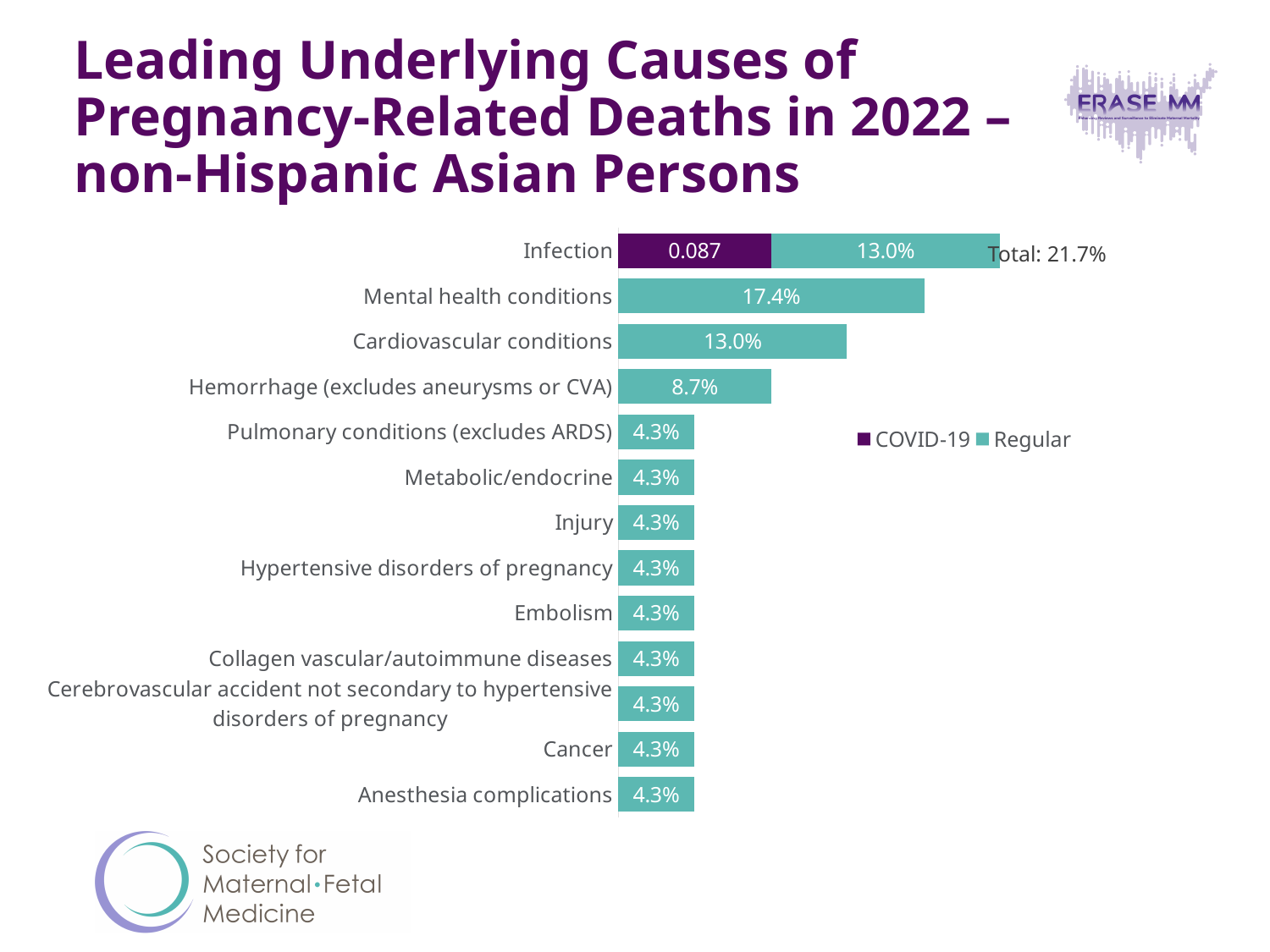
What is the Regular value for Mental health conditions? 17.4% What is the total shown for the Infection bar? 21.7% What is the Regular value for Cardiovascular conditions? 13.0% What kind of chart is shown on the slide? Bar chart What is the Regular value for Hemorrhage (excludes aneurysms or CVA)? 8.7% What is the difference between the Regular values for Mental health conditions and Cardiovascular conditions? 4.4% What is the Regular value for Anesthesia complications? 4.3% What value is printed on the COVID-19 segment of the Infection bar? 0.087 How many categories are shown on the chart? 13 How many series does the legend list? 2 Which is larger: the Regular value for Mental health conditions or for Hemorrhage (excludes aneurysms or CVA)? Mental health conditions Which category has the longest bar overall? Infection